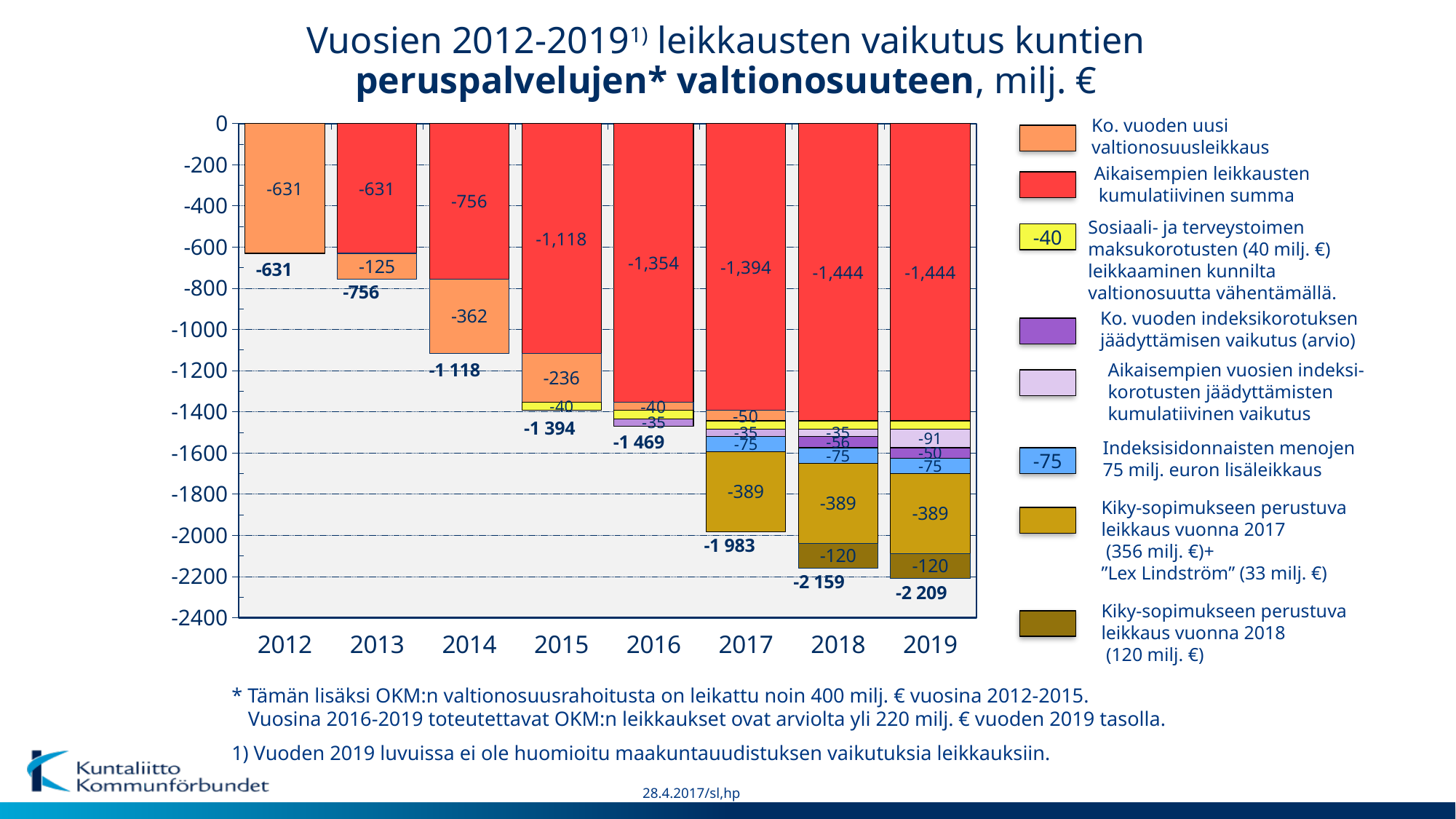
Which year has the smallest total cut (least negative total)? 2012 Do the total cuts become larger or smaller in magnitude from 2012 to 2019? Larger Which year has the largest total cut (most negative total)? 2019 What is the total value printed below the bar for 2019? -2 209 What is the difference between the total for 2019 (-2 209) and the total for 2018 (-2 159)? 50 What is the value of the 'Ko. vuoden uusi valtionosuusleikkaus' (orange) segment in 2014? -362 What is the total value printed below the bar for 2017? -1 983 What is the value of the 'Aikaisempien vuosien indeksikorotusten jäädyttämisten kumulatiivinen vaikutus' (light purple) segment in 2019? -91 What is the value of the 'Aikaisempien leikkausten kumulatiivinen summa' (red) segment in 2016? -1,354 How many series does the legend list? 8 What type of chart is shown on the slide? Stacked bar chart How many years (categories) are shown on the x axis? 8